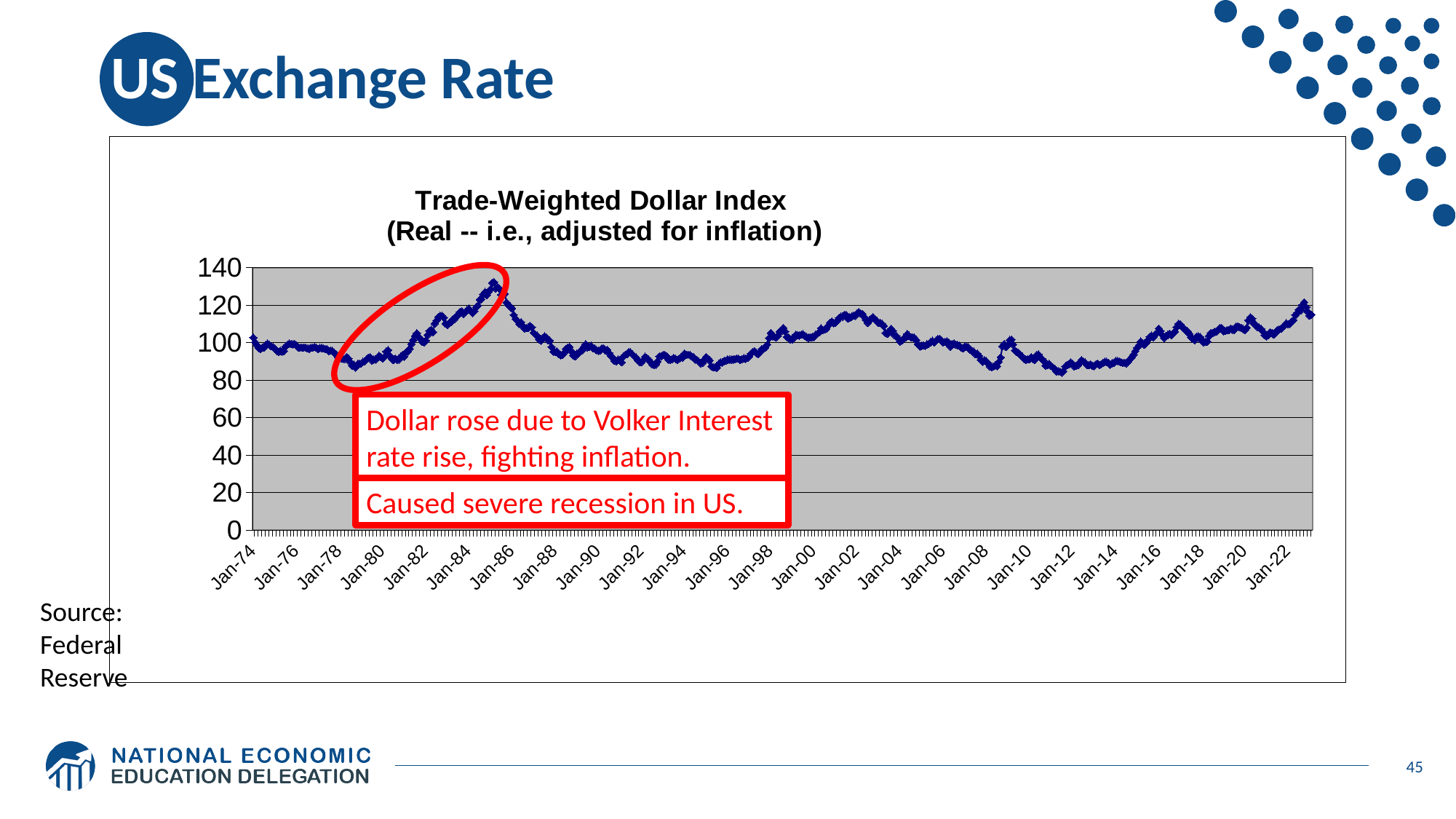
What is the title of the chart? Trade-Weighted Dollar Index (Real -- i.e., adjusted for inflation) Is the value of the index around Jan-02 greater or less than 100? greater How many labels are shown on the x axis? 25 Does the index rise or fall between Jan-80 and Jan-86? rise Is the value of the index around Jan-12 greater or less than 100? less What is the highest value shown on the y axis? 140 Is the value of the index around Jan-92 greater or less than 100? less Does the index rise or fall between Jan-02 and Jan-08? fall What kind of chart is shown on the slide? line chart Around which x-axis label does the Trade-Weighted Dollar Index reach its highest value? Jan-86 Does the index rise or fall between Jan-86 and Jan-88? fall